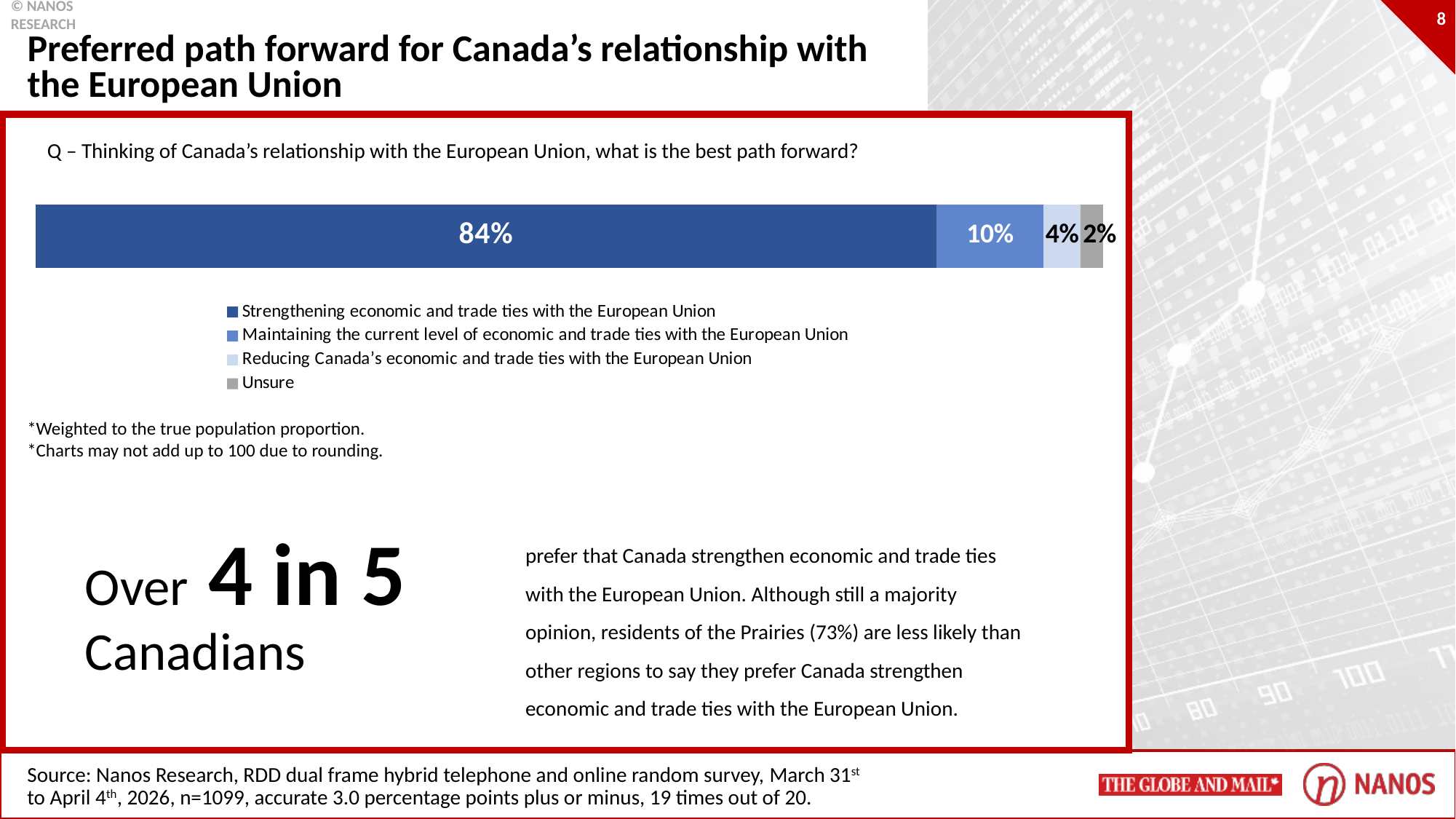
What kind of chart is shown on the slide? Stacked bar chart What percentage of respondents prefer reducing Canada's economic and trade ties with the European Union? 4% What colour is the segment representing 'Unsure'? Grey Which response option has the highest share? Strengthening economic and trade ties with the European Union What percentage of respondents prefer strengthening economic and trade ties with the European Union? 84% What percentage of respondents prefer maintaining the current level of economic and trade ties with the European Union? 10% What percentage of respondents are unsure? 2% Which is larger: the share preferring to reduce ties or the share that is unsure? Reducing Canada's economic and trade ties with the European Union How many response options does the legend list? 4 What is the difference in percentage points between those who prefer strengthening ties and those who prefer maintaining the current level of ties? 74 What is the total of all segments in the stacked bar? 100% Which response option has the lowest share? Unsure